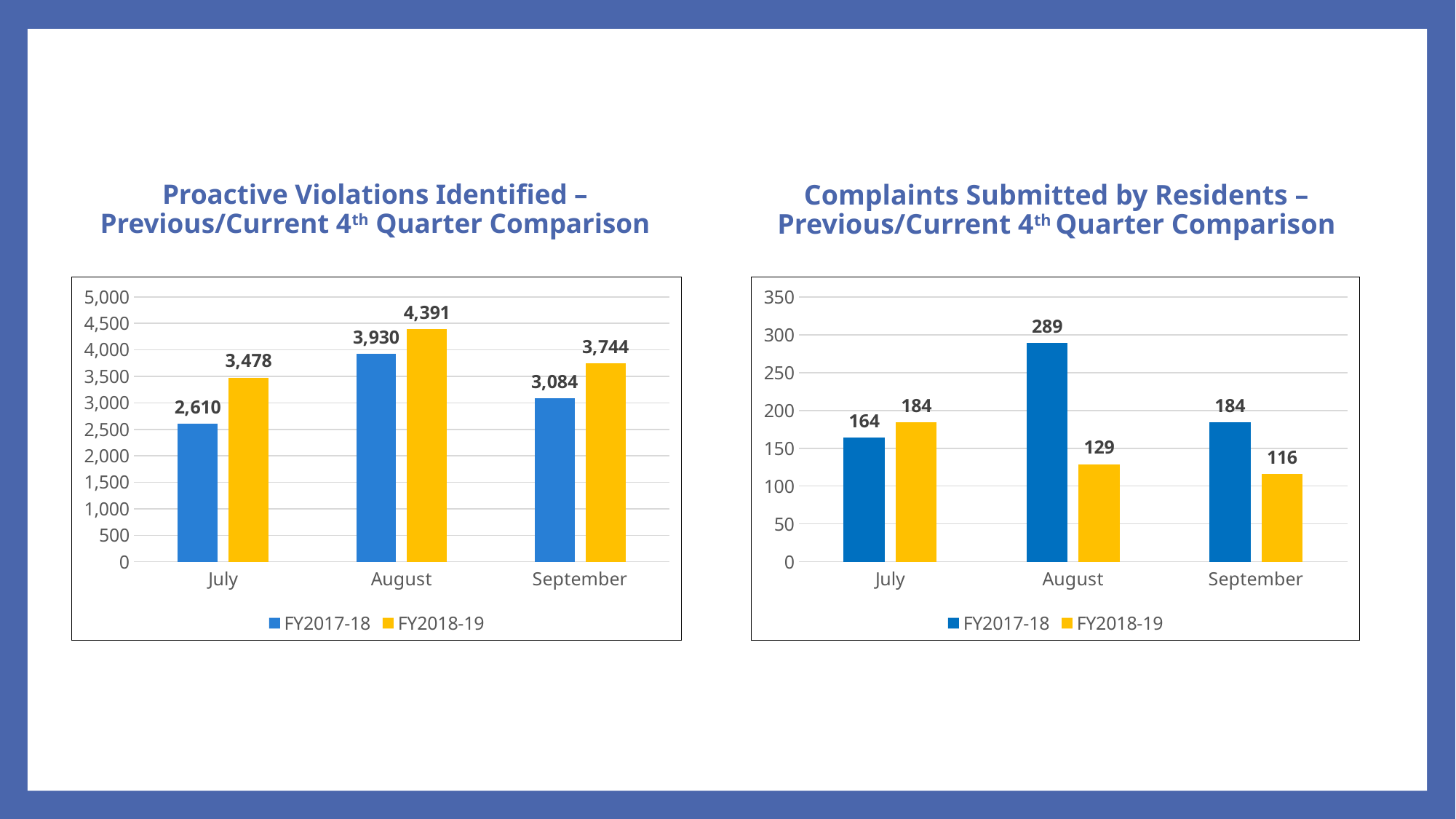
In the Complaints Submitted by Residents chart, what is the FY2017-18 value for August? 289 In the Complaints Submitted by Residents chart, what is the difference between the FY2017-18 and FY2018-19 values for August? 160 In the Proactive Violations Identified chart, how many months are shown on the x axis? 3 In the Proactive Violations Identified chart, what is the difference between the FY2018-19 and FY2017-18 values for September? 660 In the Complaints Submitted by Residents chart, which month has the lowest FY2018-19 value? September In the Proactive Violations Identified chart, what is the FY2018-19 value for August? 4,391 In the Proactive Violations Identified chart, which month has the highest FY2017-18 value? August What type of chart is the Proactive Violations Identified chart? Bar chart In the Complaints Submitted by Residents chart, how many series does the legend list? 2 In the Proactive Violations Identified chart, what is the FY2017-18 value for July? 2,610 In the Complaints Submitted by Residents chart, which is larger for July: FY2017-18 or FY2018-19? FY2018-19 In the Complaints Submitted by Residents chart, what is the FY2018-19 value for September? 116